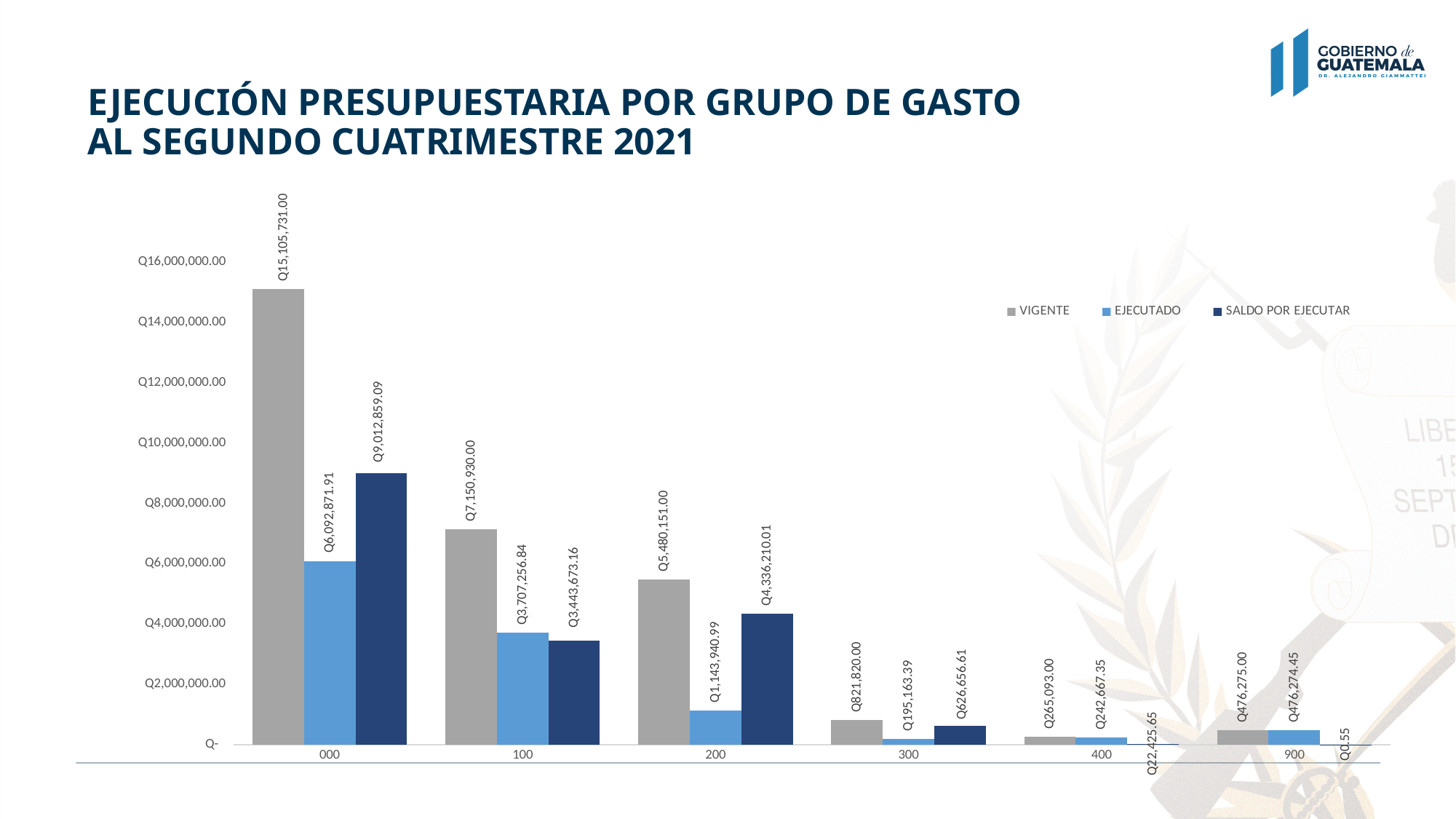
Which group has the highest VIGENTE value? 000 How many expense groups are shown on the x axis? 6 Do the VIGENTE values rise or fall from group 000 to group 400? fall What kind of chart is shown on the slide? bar chart What is the difference between the VIGENTE and EJECUTADO values for group 100? Q3,443,673.16 Is the VIGENTE value for group 000 greater or less than Q14,000,000.00? greater How many series does the legend list? 3 Which group has the lowest VIGENTE value? 400 What is the EJECUTADO value for group 200? Q1,143,940.99 What is the SALDO POR EJECUTAR value for group 900? Q0.55 For group 200, which is larger: EJECUTADO or SALDO POR EJECUTAR? SALDO POR EJECUTAR What is the VIGENTE value for group 000? Q15,105,731.00